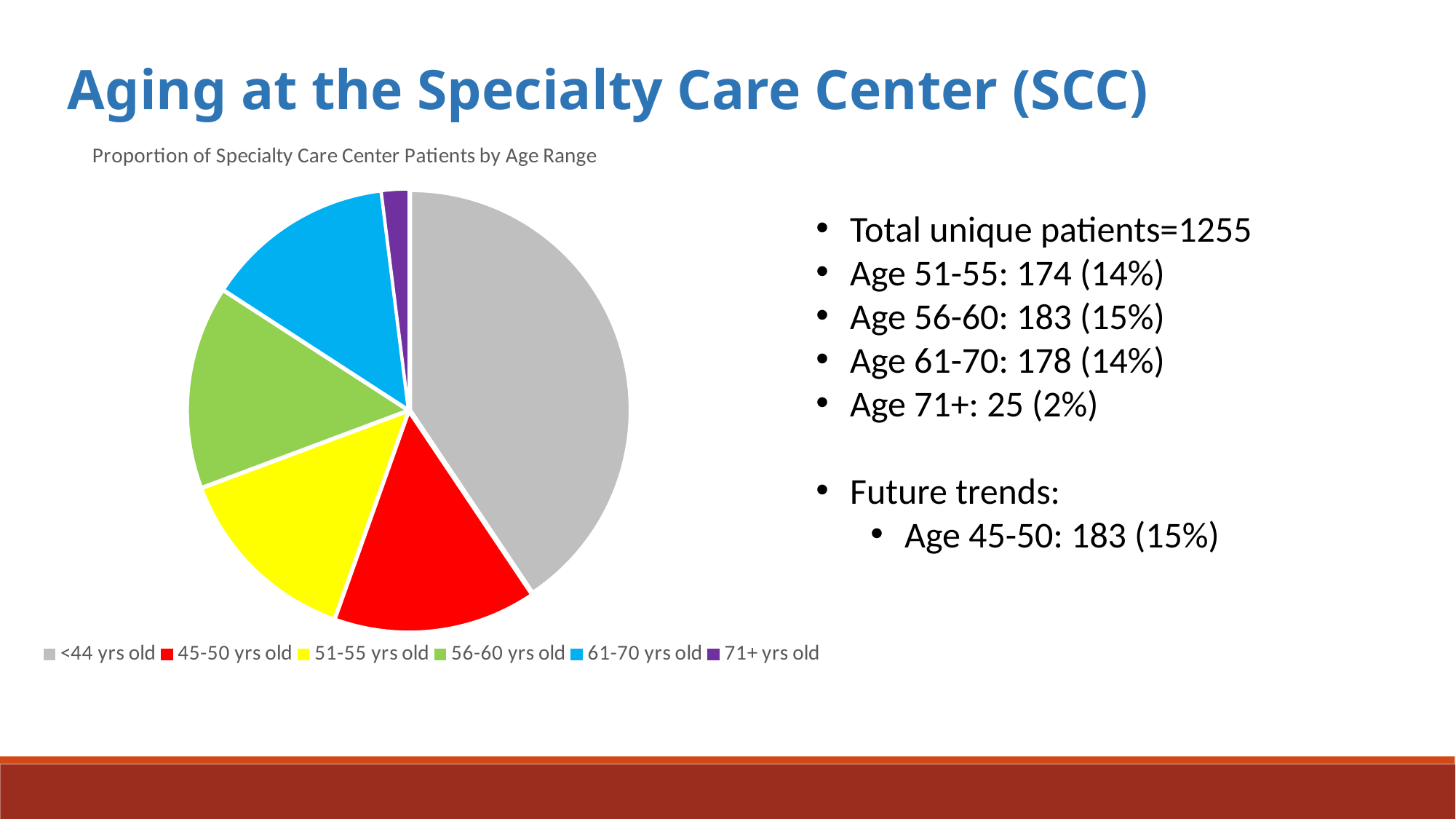
What colour represents the <44 yrs old slice in the pie chart? gray What kind of chart is shown on the slide? pie chart Which age range has the smallest slice of the pie chart? 71+ yrs old According to the slide, what share of patients are in the 71+ age range? 2% What is the title of the pie chart? Proportion of Specialty Care Center Patients by Age Range How many age-range slices does the pie chart have? 6 According to the slide, what share of patients are in the 51-55 age range? 14% How many entries does the legend of the pie chart list? 6 According to the slide, how many patients are in the 56-60 age range? 183 Which age range has the largest slice of the pie chart? <44 yrs old Which slice is larger in the pie chart: 61-70 yrs old or 71+ yrs old? 61-70 yrs old Which slice is larger in the pie chart: <44 yrs old or 45-50 yrs old? <44 yrs old